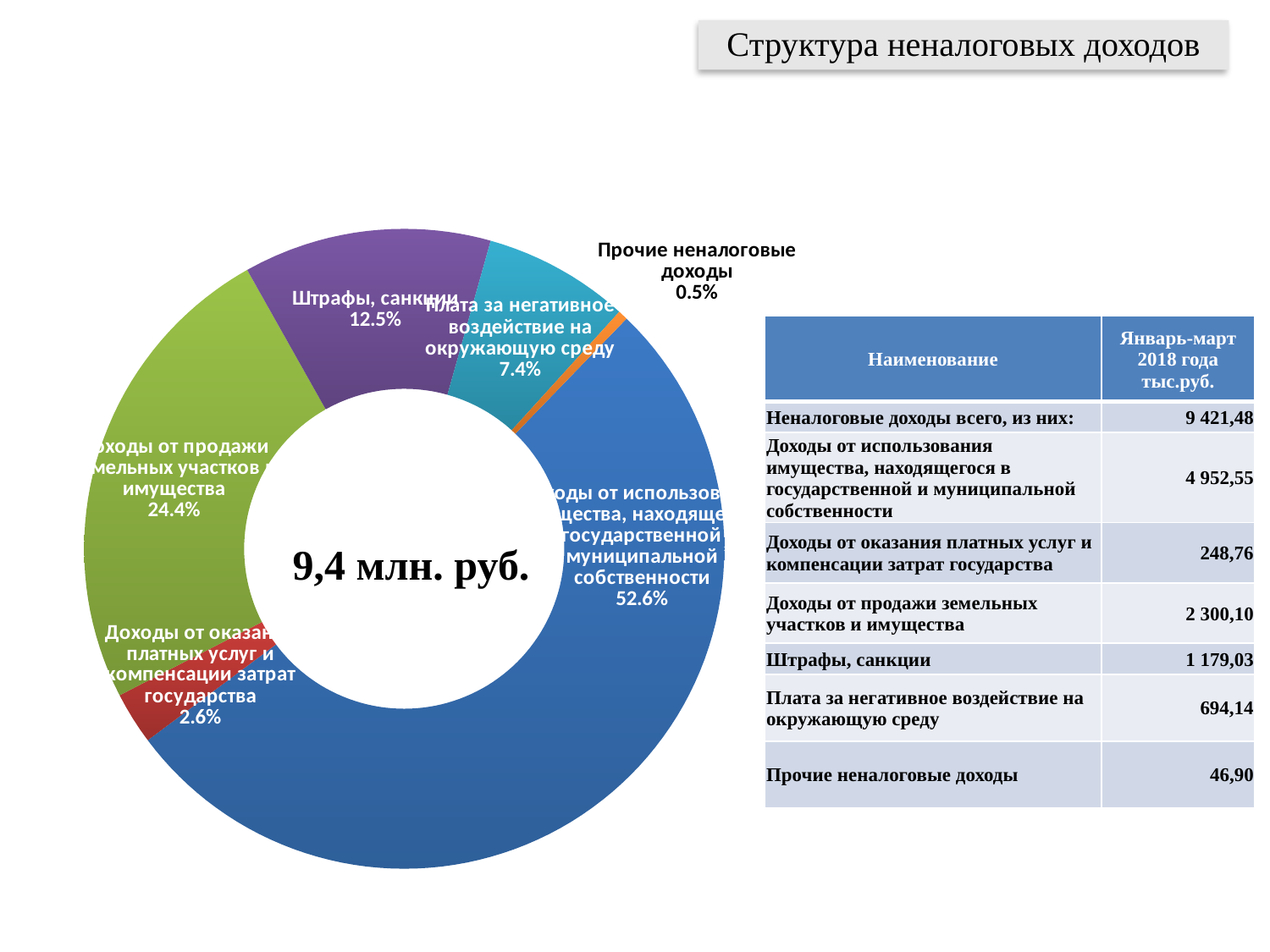
By how many percentage points does the share of "Штрафы, санкции" exceed that of "Плата за негативное воздействие на окружающую среду"? 5.1 percentage points What share of the chart is "Доходы от продажи земельных участков и имущества"? 24.4% Which is larger: the share of "Доходы от продажи земельных участков и имущества" or the share of "Штрафы, санкции"? Доходы от продажи земельных участков и имущества Which category has the largest share of the chart? Доходы от использования имущества, находящегося в государственной и муниципальной собственности How many slices does the chart have? 6 What percentage is shown for "Доходы от оказания платных услуг и компенсации затрат государства"? 2.6% What kind of chart is shown on the slide? Doughnut (pie) chart What total value is printed in the centre of the chart? 9,4 млн. руб. What percentage is shown for "Прочие неналоговые доходы"? 0.5% What percentage is shown for "Плата за негативное воздействие на окружающую среду"? 7.4% What share of the chart does "Штрафы, санкции" represent? 12.5% Which category has the smallest share of the chart? Прочие неналоговые доходы